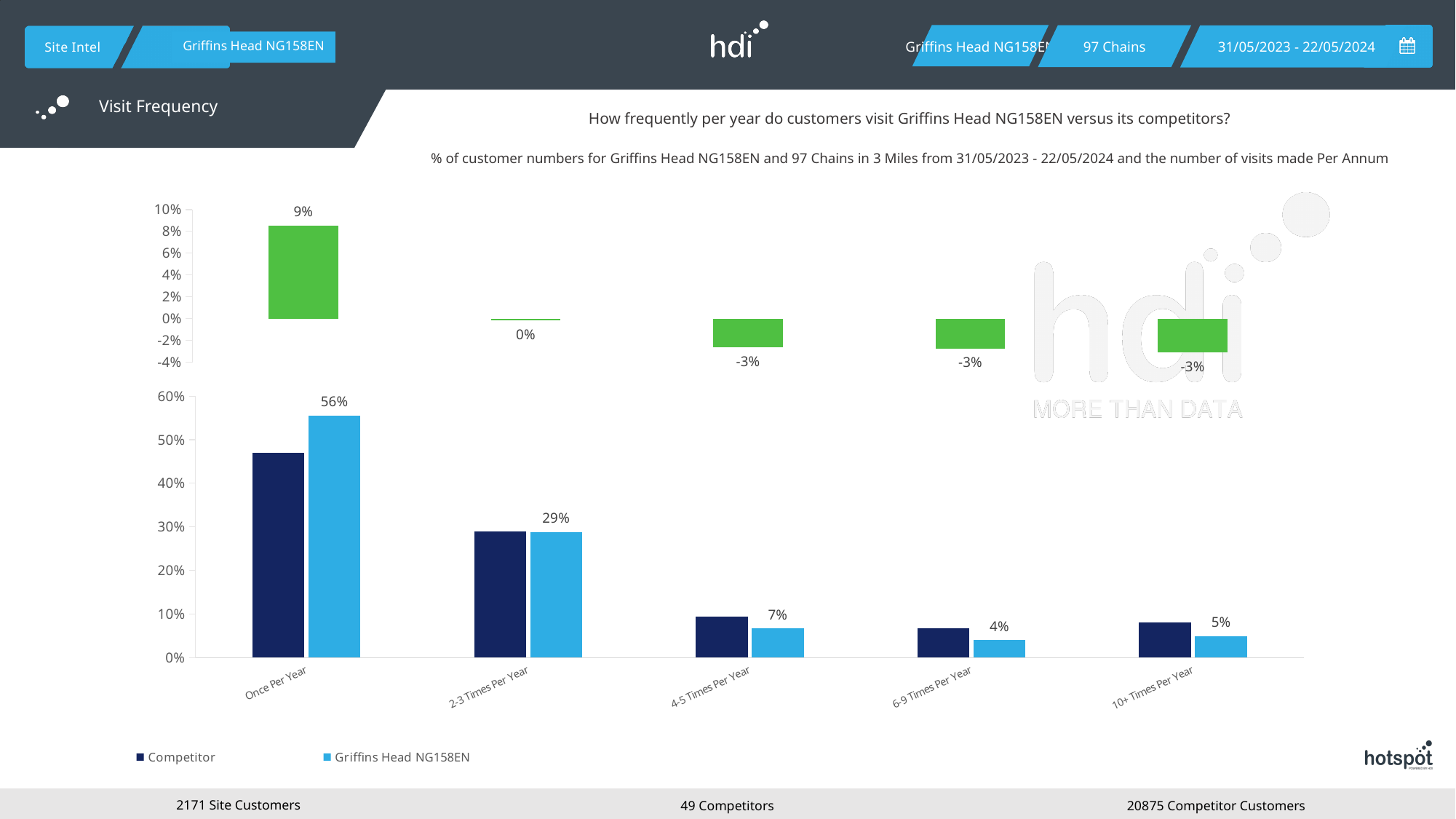
In the bottom chart, for Once Per Year, which is larger: the Competitor bar or the Griffins Head NG158EN bar? Griffins Head NG158EN In the bottom chart, what is the value for Griffins Head NG158EN for 6-9 Times Per Year? 4% In the bottom chart, what is the value for Griffins Head NG158EN for 2-3 Times Per Year? 29% In the bottom chart, which category has the highest value for Griffins Head NG158EN? Once Per Year In the bottom chart, is the Competitor value for 4-5 Times Per Year greater or less than 20%? less In the top green chart, what is the value for Once Per Year? 9% In the bottom chart, which category has the lowest value for Griffins Head NG158EN? 6-9 Times Per Year In the bottom chart, what is the value for Griffins Head NG158EN for Once Per Year? 56% In the top green chart, what is the value for 4-5 Times Per Year? -3% How many series does the legend of the bottom chart list? 2 In the bottom chart, what is the difference between the Griffins Head NG158EN values for Once Per Year and 2-3 Times Per Year? 27% In the bottom chart, is the Competitor value for Once Per Year greater or less than 40%? greater